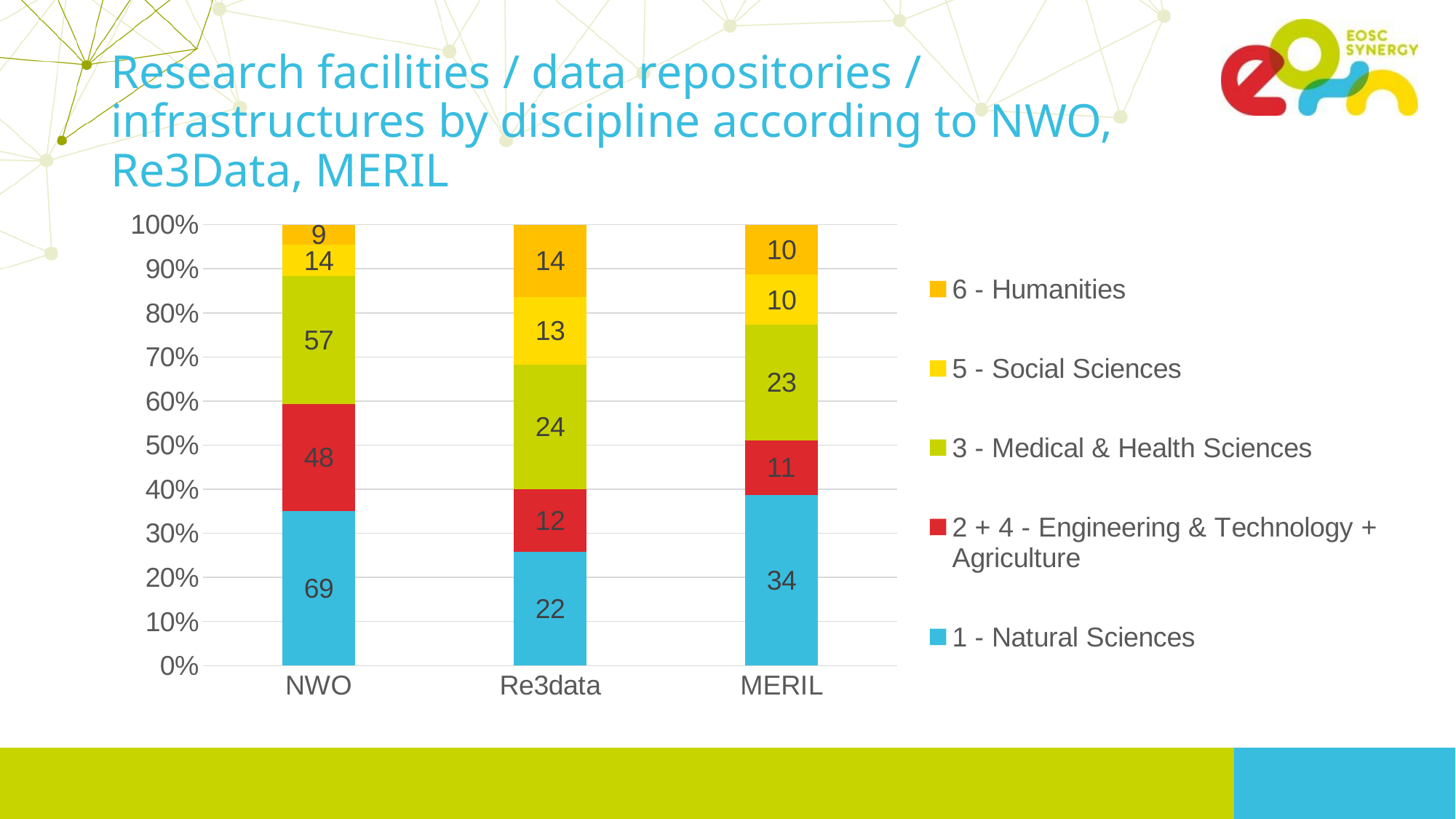
How many series does the legend list? 5 Which is larger: the 5 - Social Sciences value for NWO or for Re3data? NWO How many categories are shown on the x axis? 3 Which category has the highest value for 1 - Natural Sciences? NWO What is the difference between the 1 - Natural Sciences values for NWO and MERIL? 35 What is the value for 1 - Natural Sciences in the NWO bar? 69 What kind of chart is shown on the slide? Stacked bar chart Which category has the lowest value for 3 - Medical & Health Sciences? MERIL What is the value for 3 - Medical & Health Sciences in the Re3data bar? 24 What is the value for 6 - Humanities in the MERIL bar? 10 What is the total of all segments in the Re3data bar? 85 What is the value for 2 + 4 - Engineering & Technology + Agriculture in the NWO bar? 48